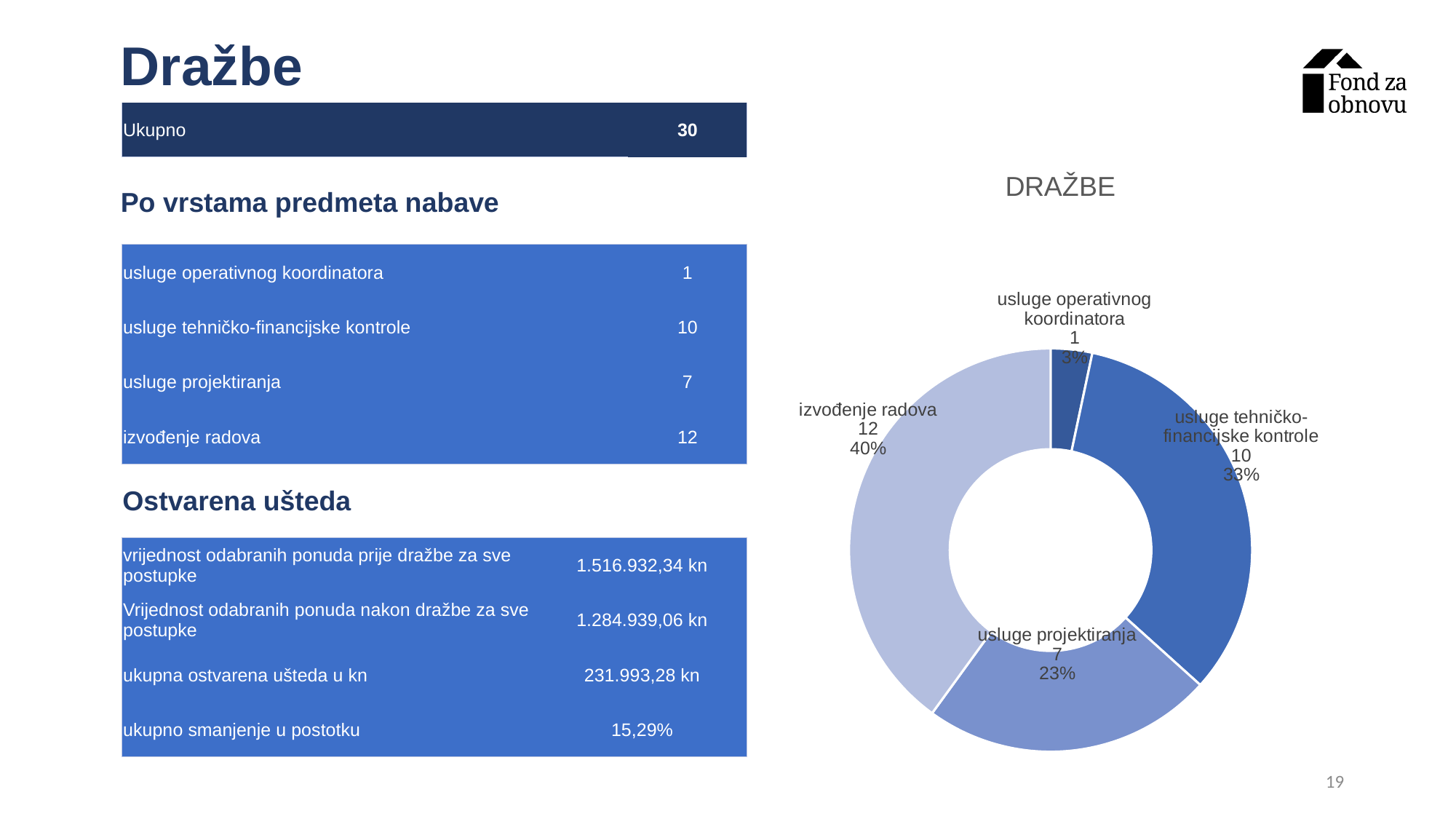
What is the difference between the values for izvođenje radova and usluge projektiranja? 5 What percentage share does izvođenje radova have in the chart? 40% How many categories does the chart show? 4 What is the value for usluge projektiranja in the chart? 7 Which category has the smallest share of the chart? usluge operativnog koordinatora What type of chart is shown on the slide? Doughnut chart What is the value for usluge operativnog koordinatora in the chart? 1 Which category has the largest share of the chart? izvođenje radova What is the value for izvođenje radova in the chart? 12 What percentage share does usluge projektiranja have in the chart? 23% What is the title of the chart? DRAŽBE What is the value for usluge tehničko-financijske kontrole in the chart? 10